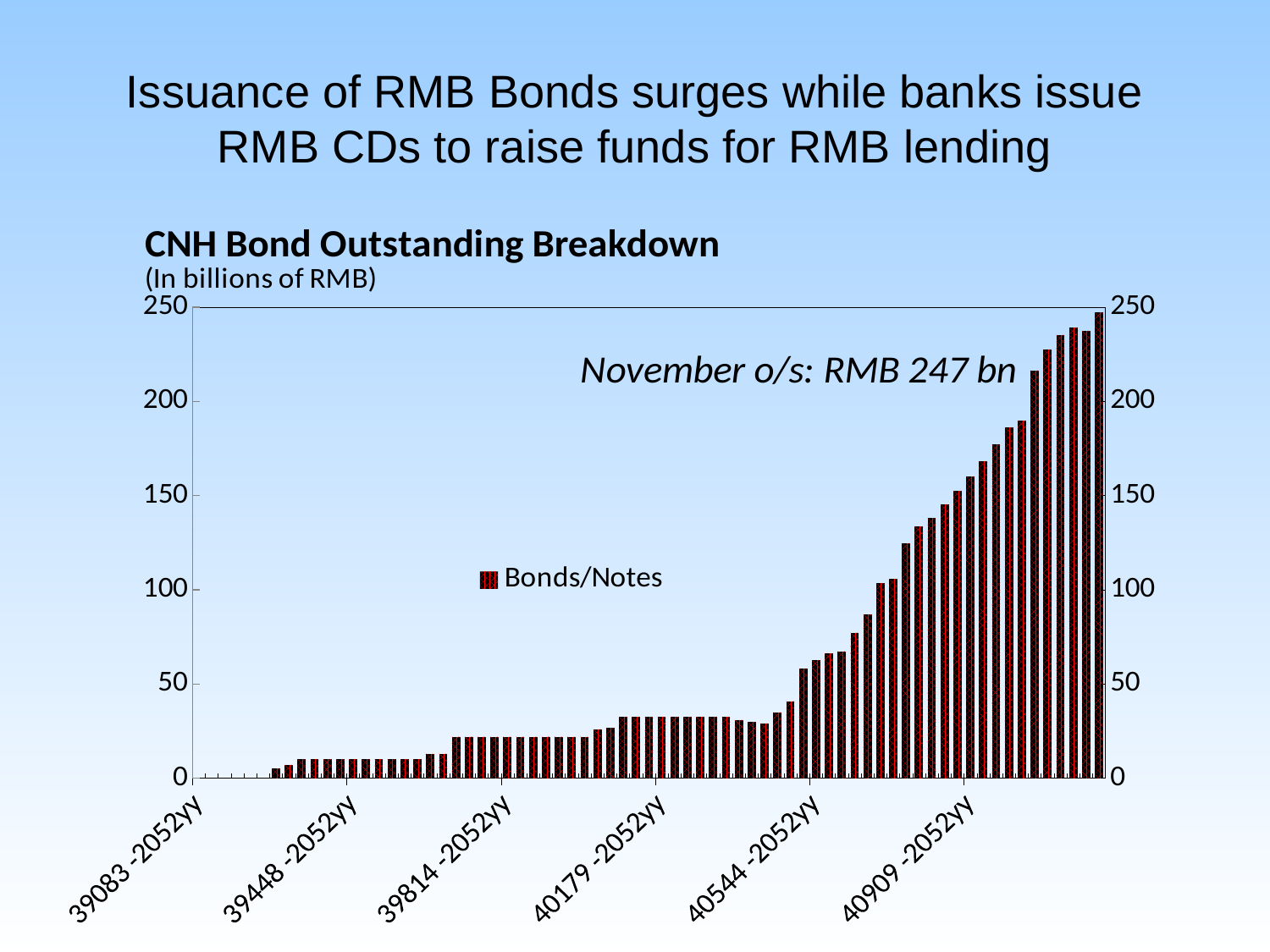
In what units are the chart's values expressed? In billions of RMB Is the value of the rightmost bar greater or less than 200? greater What is the name of the series shown in the legend? Bonds/Notes According to the annotation on the chart, what is the November outstanding amount? RMB 247 bn How many series does the chart's legend list? 1 Is the value at the 40544 -2052yy tick greater or less than 100? less What kind of chart is shown on the slide? bar chart What is the maximum value shown on the vertical axis? 250 Is the value at the 40909 -2052yy tick greater or less than 100? greater What is the title of the chart? CNH Bond Outstanding Breakdown Do the values generally rise or fall from left to right along the x axis? rise